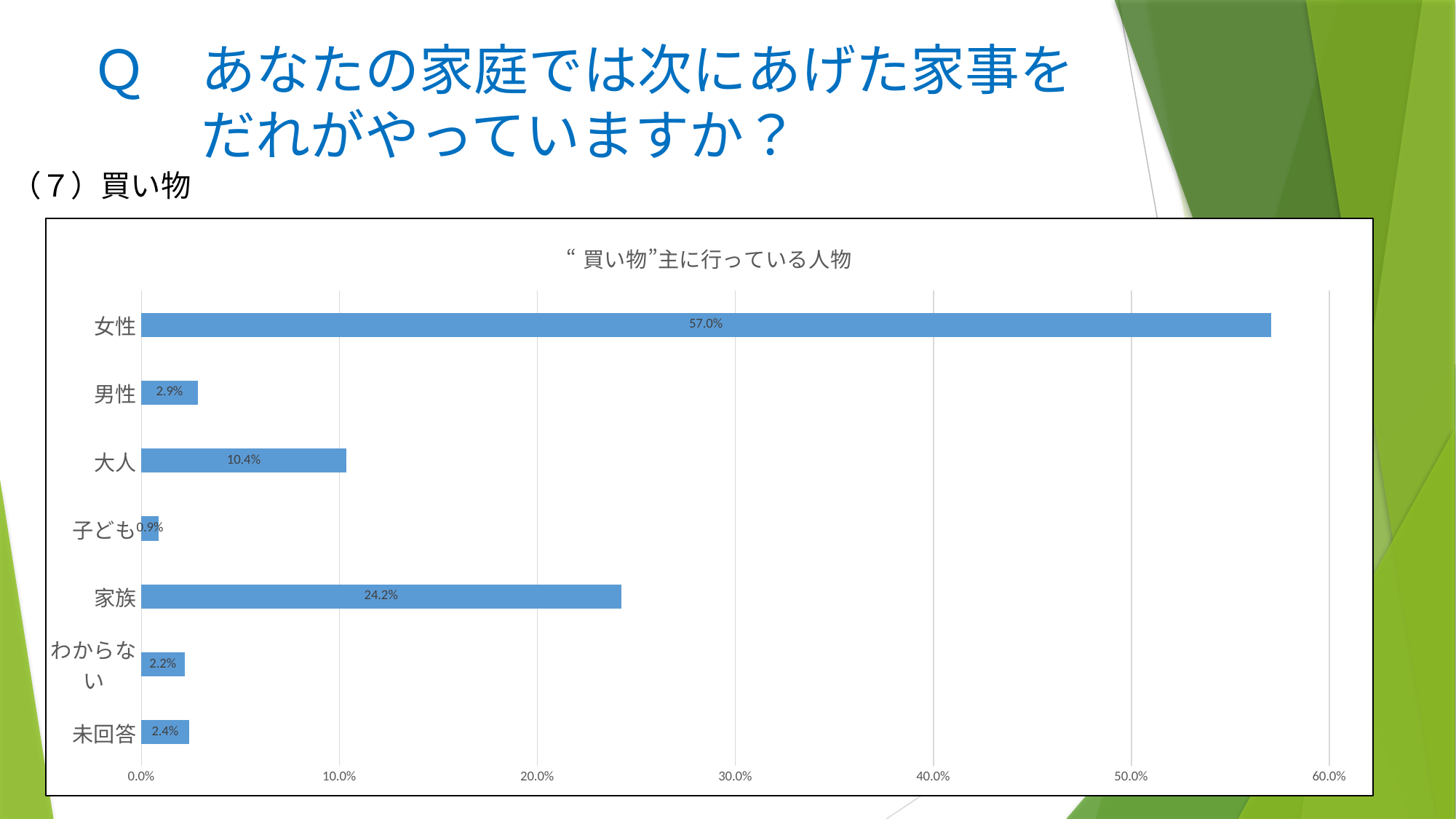
Which is larger, the value for 男性 or the value for 大人? 大人 Which category has the highest value? 女性 What is the difference between the values for 女性 and 家族? 32.8% What is the value for 大人? 10.4% What is the value for 女性? 57.0% What is the value for 子ども? 0.9% What is the title of the chart? “ 買い物”主に行っている人物 How many categories are shown in the chart? 7 What is the value for 家族? 24.2% What kind of chart is shown on the slide? bar chart Is the value for 家族 greater or less than 20.0%? greater Which category has the lowest value? 子ども